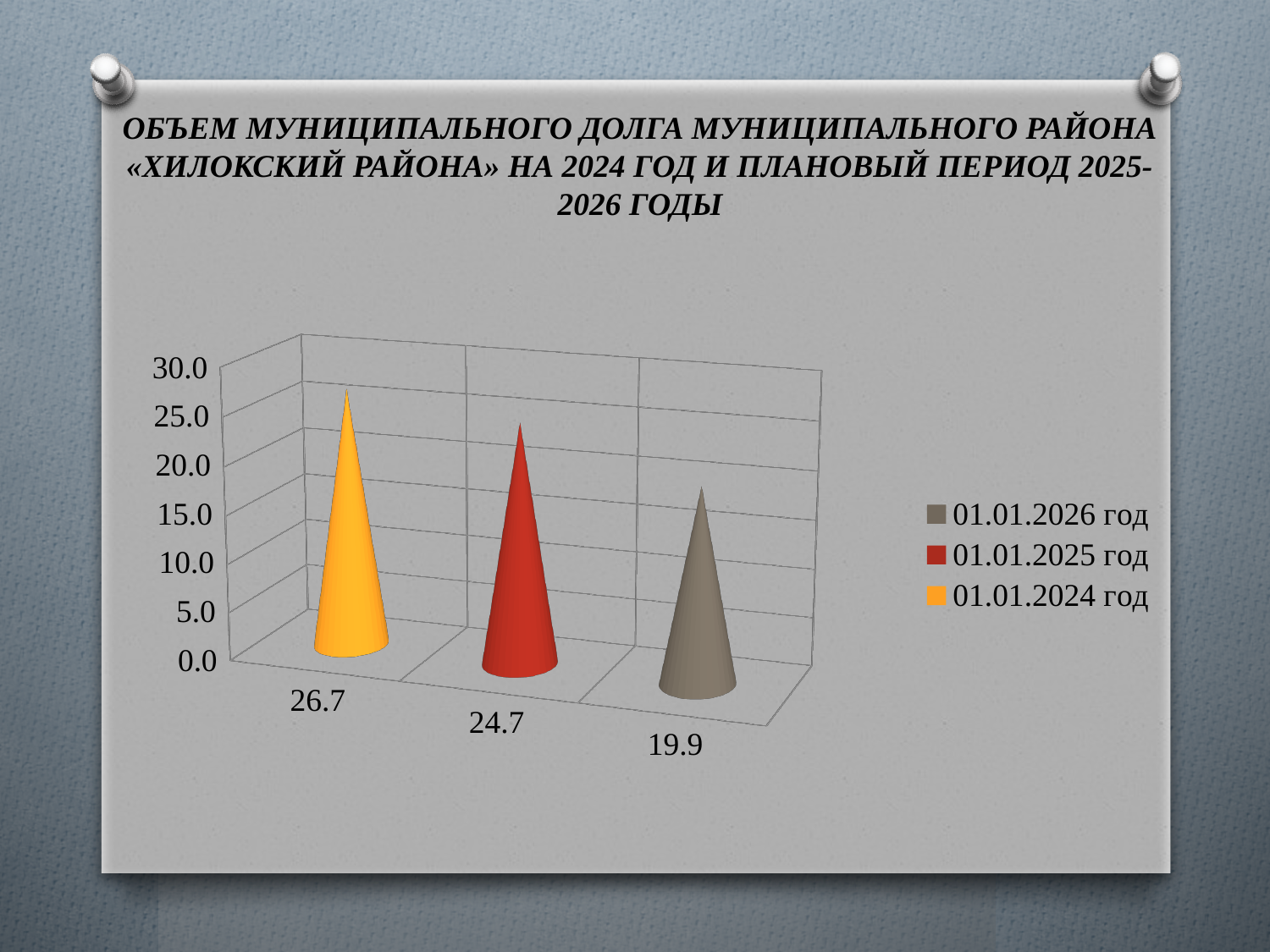
Do the values rise or fall from 01.01.2024 год to 01.01.2026 год? fall What kind of chart is shown on the slide? bar chart What is the value for 01.01.2024 год? 26.7 What is the value for 01.01.2025 год? 24.7 Which series has the highest value? 01.01.2024 год How many series does the legend list? 3 What is the difference between the values for 01.01.2024 год and 01.01.2026 год? 6.8 What is the value for 01.01.2026 год? 19.9 Which series has the lowest value? 01.01.2026 год Which is larger, the value for 01.01.2025 год or for 01.01.2026 год? 01.01.2025 год What is the difference between the values for 01.01.2024 год and 01.01.2025 год? 2.0 Is the value for 01.01.2024 год greater or less than 25.0? greater